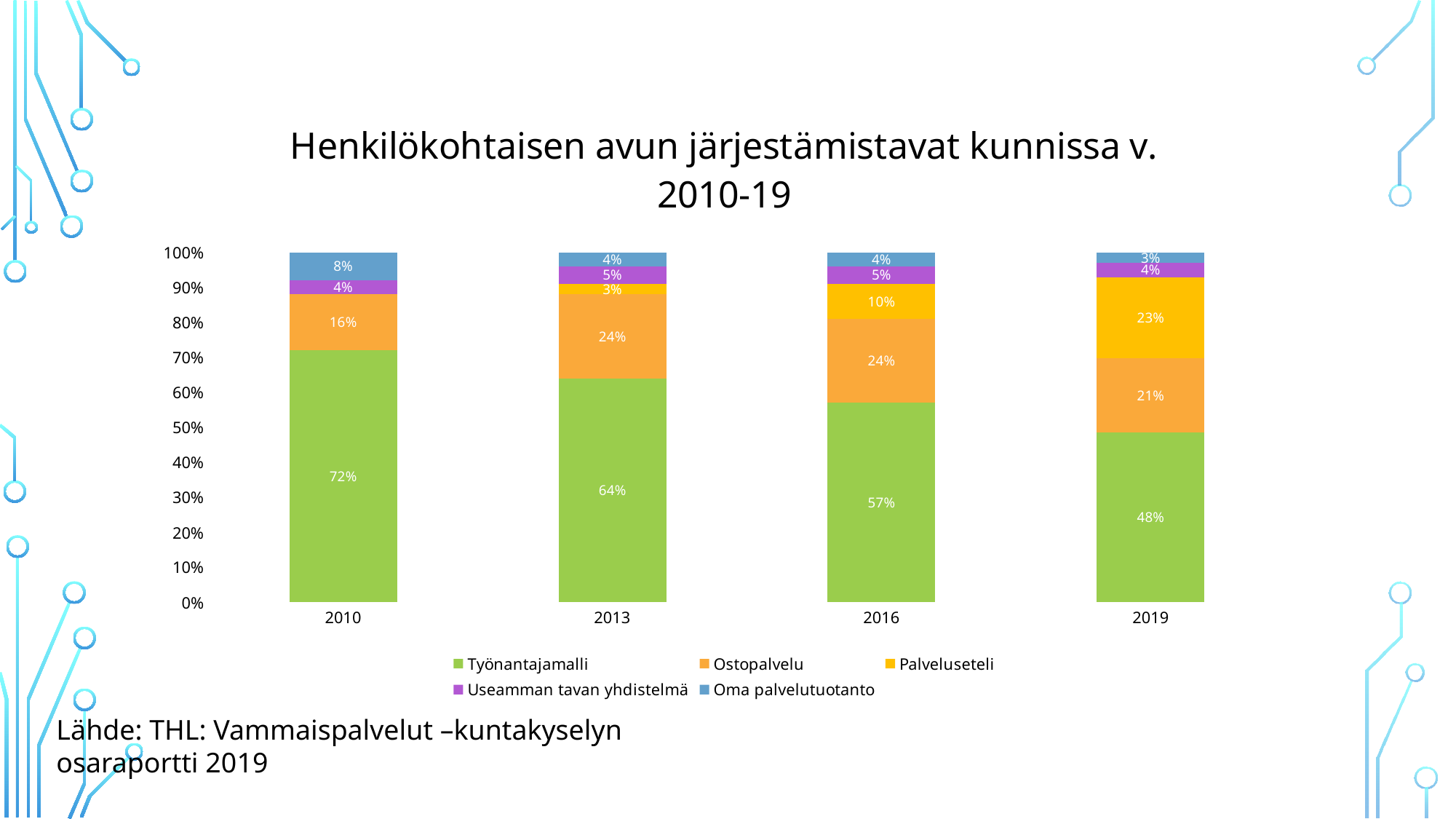
What is the value for Ostopalvelu in 2013? 24% How does the Työnantajamalli share change from 2010 to 2019? It falls What is the value for Oma palvelutuotanto in 2010? 8% What is the value for Palveluseteli in 2019? 23% How many years are shown on the x axis? 4 In which year is the Palveluseteli share the highest? 2019 What is the value for Työnantajamalli in 2010? 72% Which is larger in 2016: the Ostopalvelu share or the Palveluseteli share? Ostopalvelu What is the difference between the Työnantajamalli share in 2010 and in 2019? 24 percentage points What kind of chart is shown on the slide? Stacked bar chart How many series does the legend list? 5 In which year is the Työnantajamalli share the lowest? 2019